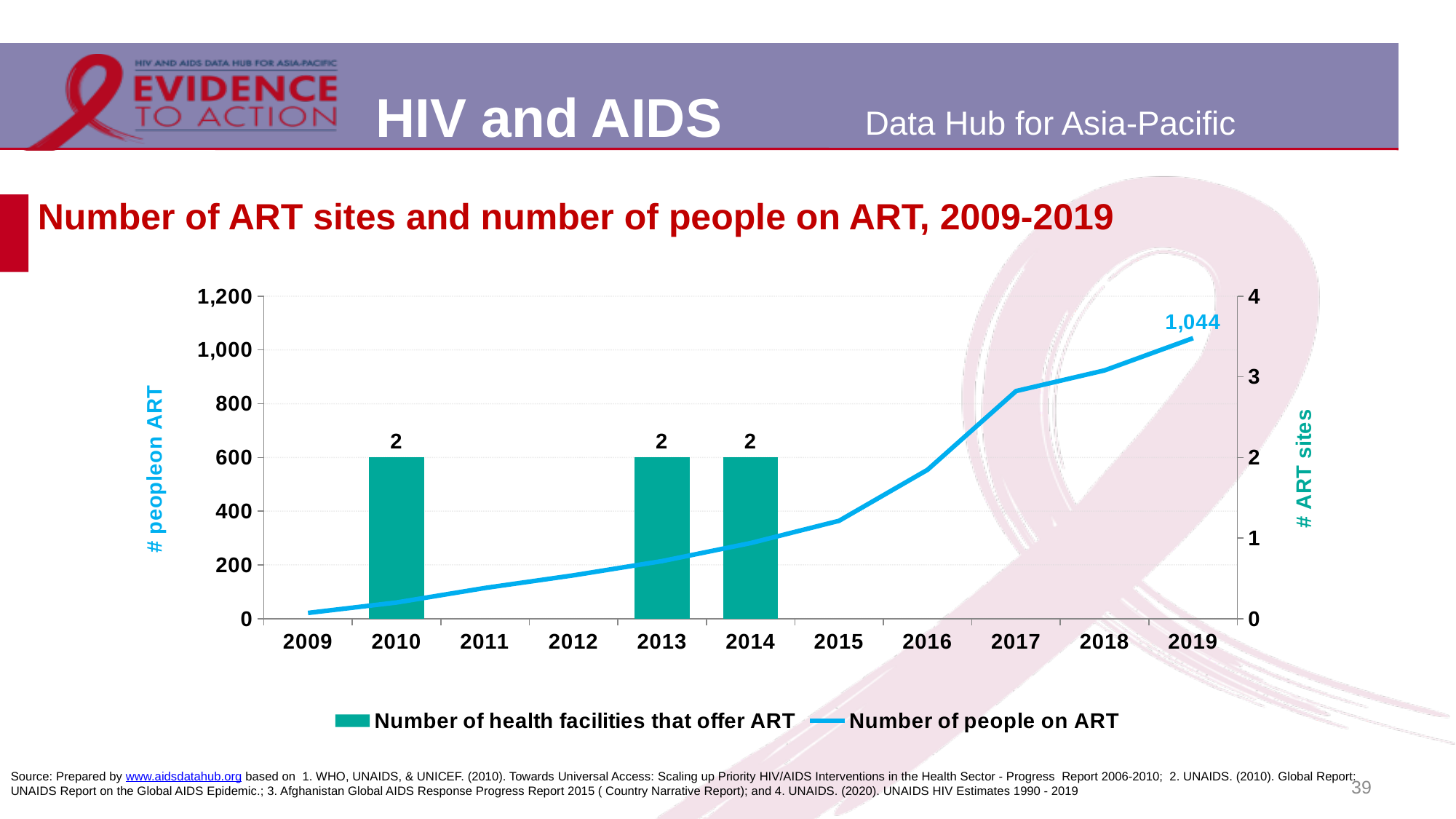
How many health facilities offered ART in 2010? 2 What kind of chart is this? Combined bar and line chart Which year has the highest number of people on ART? 2019 Is the number of people on ART in 2015 greater or less than 400? less Is the number of people on ART in 2018 greater or less than 800? greater What is the number of people on ART in 2019? 1,044 Does the number of people on ART rise or fall from 2009 to 2019? Rise How many series does the legend list? 2 How many health facilities offered ART in 2014? 2 What is the title of the right-hand vertical axis? # ART sites How many years are shown on the x axis? 11 In how many years is a bar for the number of health facilities that offer ART shown? 3